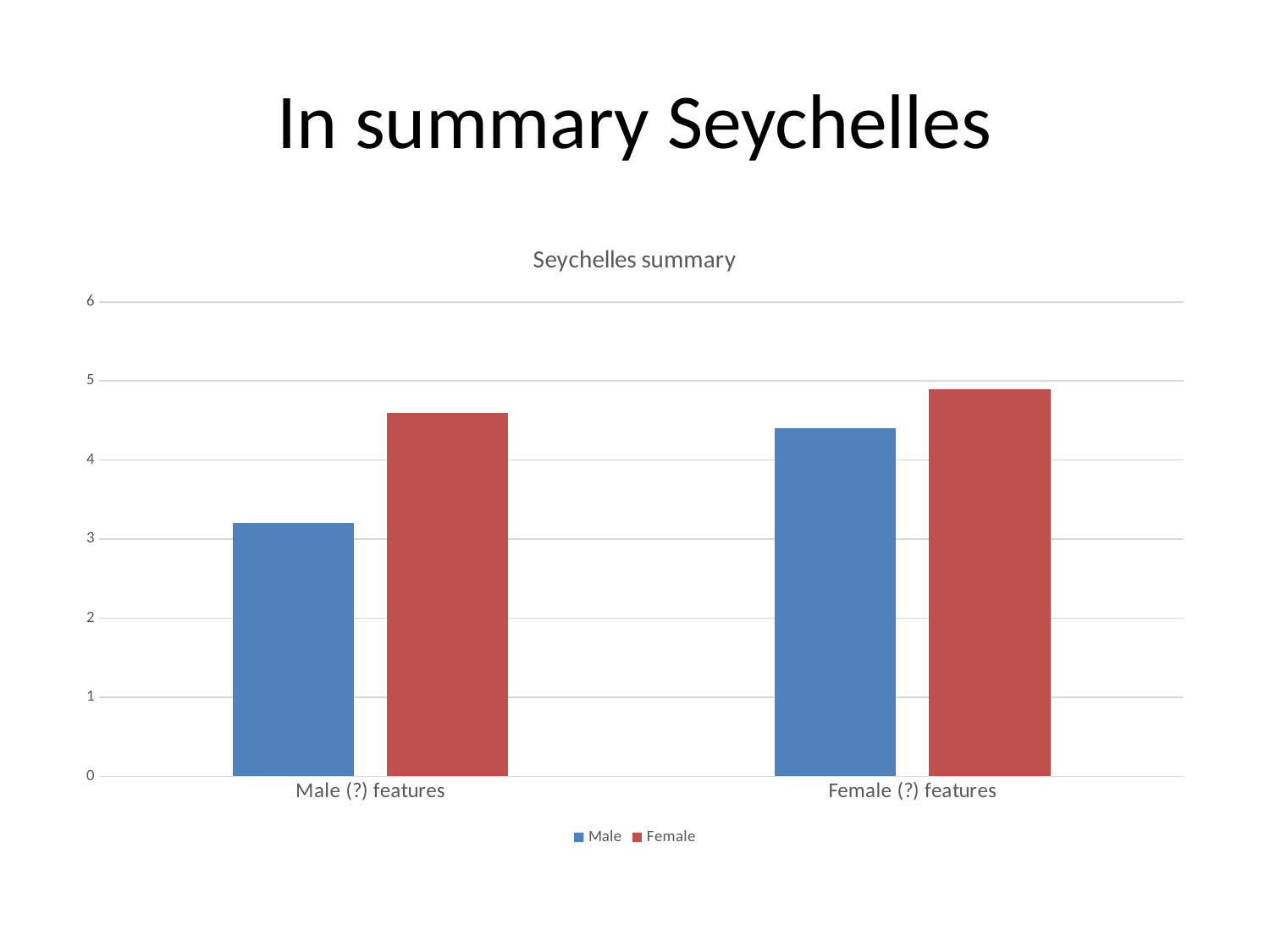
Is the Male value for Female (?) features greater or less than 5? less Which series is shown in red? Female How many series does the legend list? 2 What kind of chart is shown on the slide? bar chart How many categories are shown on the x axis? 2 Is the Female value for Male (?) features greater or less than 4? greater Which bar is the lowest in the chart? Male for Male (?) features Is the Male value for Male (?) features greater or less than 3? greater What is the title of the chart? Seychelles summary For Male (?) features, which series has the larger value, Male or Female? Female For the Male series, which category has the larger value, Male (?) features or Female (?) features? Female (?) features